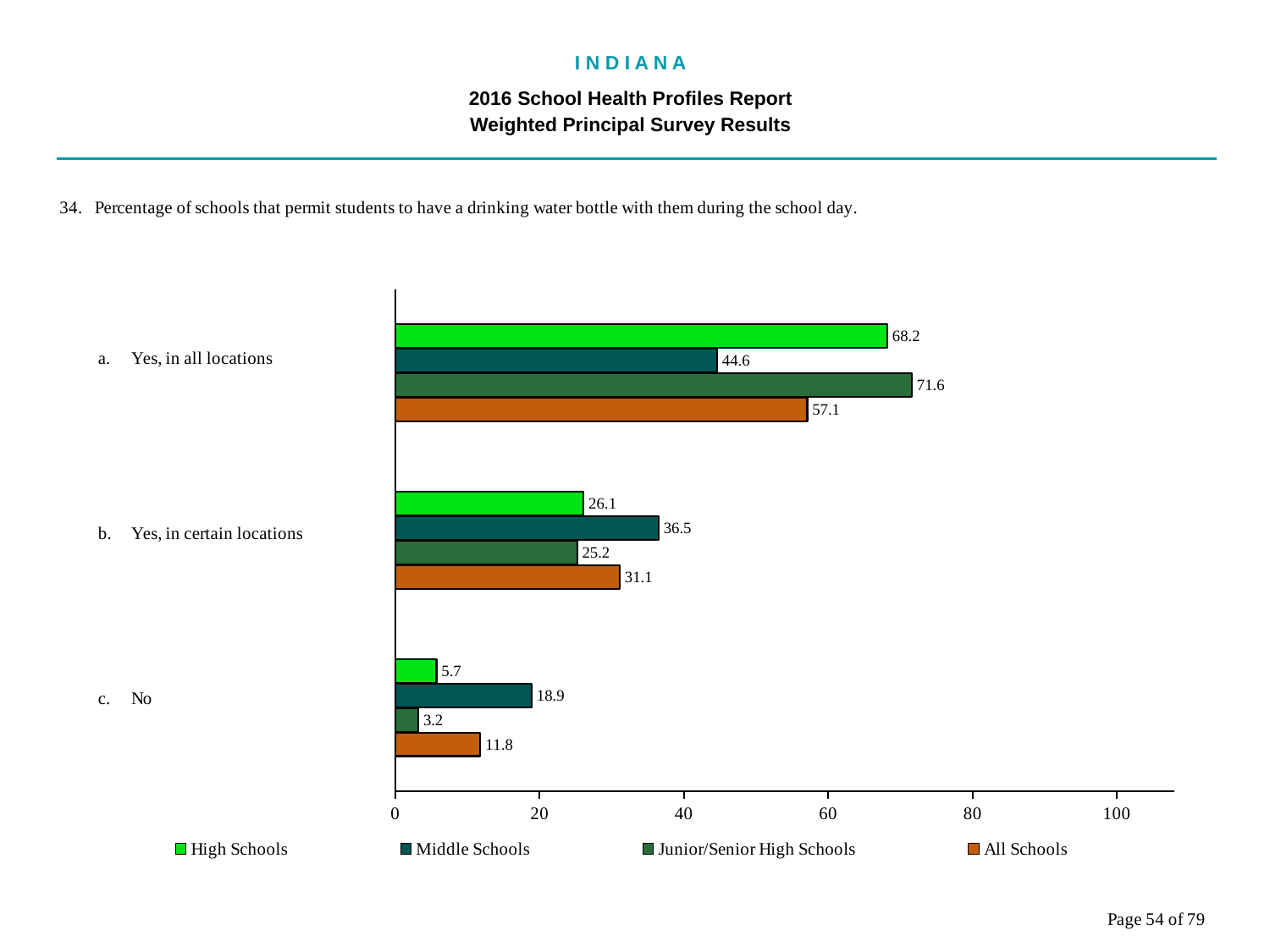
What kind of chart is shown on the slide? Bar chart Is the value for Middle Schools for "Yes, in all locations" greater or less than 40? greater How many categories are shown on the chart? 3 What is the value for High Schools for "Yes, in all locations"? 68.2 Which series has the lowest value for "No"? Junior/Senior High Schools Which is larger for "Yes, in certain locations": the All Schools value or the High Schools value? All Schools What is the value for Junior/Senior High Schools for "Yes, in all locations"? 71.6 What is the value for Middle Schools for "Yes, in certain locations"? 36.5 What is the difference between the High Schools and Middle Schools values for "Yes, in all locations"? 23.6 How many series does the legend list? 4 Which series has the highest value for "Yes, in all locations"? Junior/Senior High Schools What is the value for All Schools for "No"? 11.8